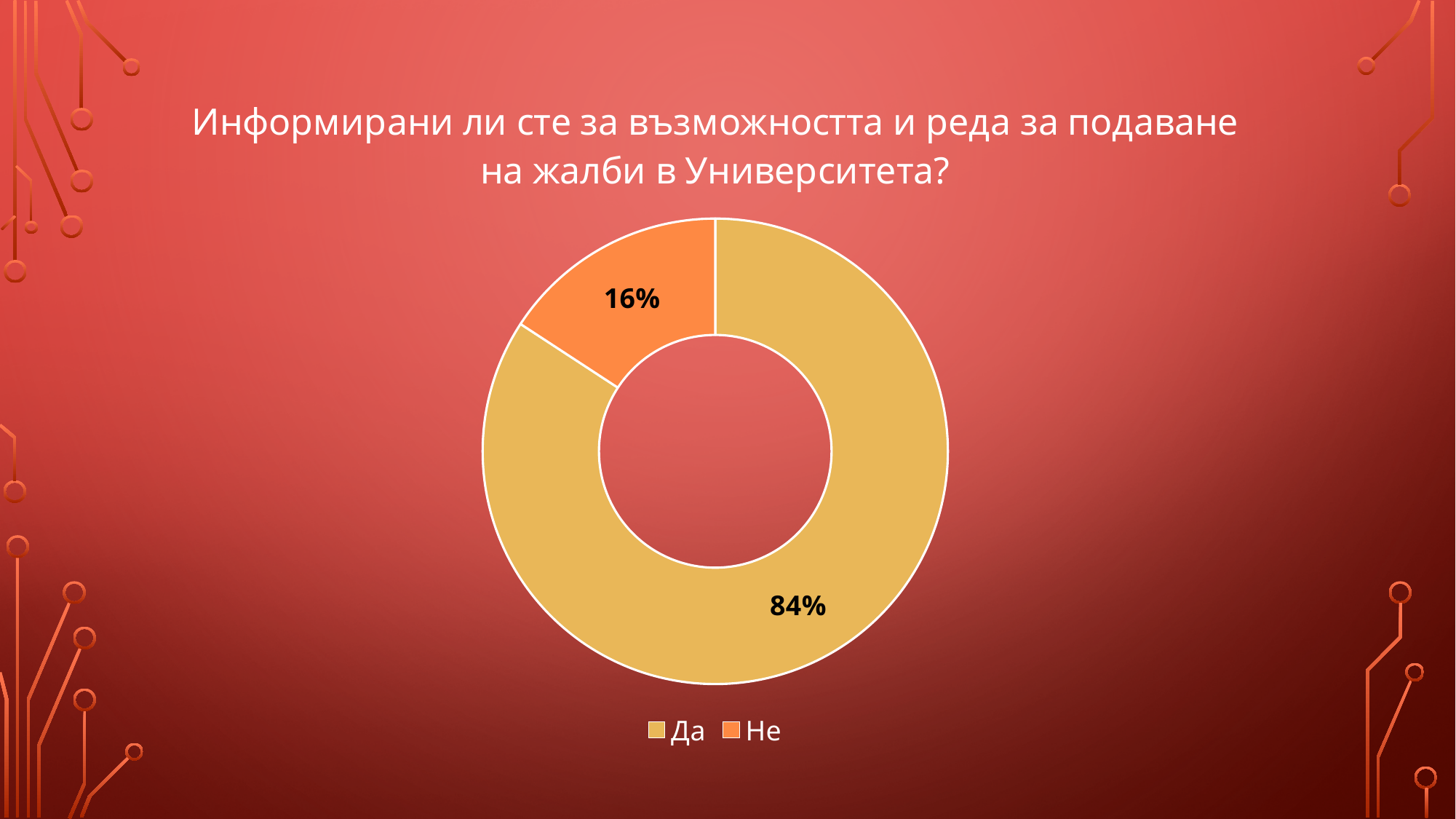
How many categories does the chart show? 2 What is the title of the chart? Информирани ли сте за възможността и реда за подаване на жалби в Университета? What is the difference in percentage points between "Да" and "Не"? 68 Which category has the smallest share of the chart? Не Which colour represents "Не" in the chart? Orange Which category has the largest share of the chart? Да What percentage of respondents answered "Не"? 16% What is the total of the two percentages shown on the chart? 100% Which is larger, the share for "Да" or the share for "Не"? Да What percentage of respondents answered "Да"? 84% What kind of chart is shown on the slide? Doughnut chart